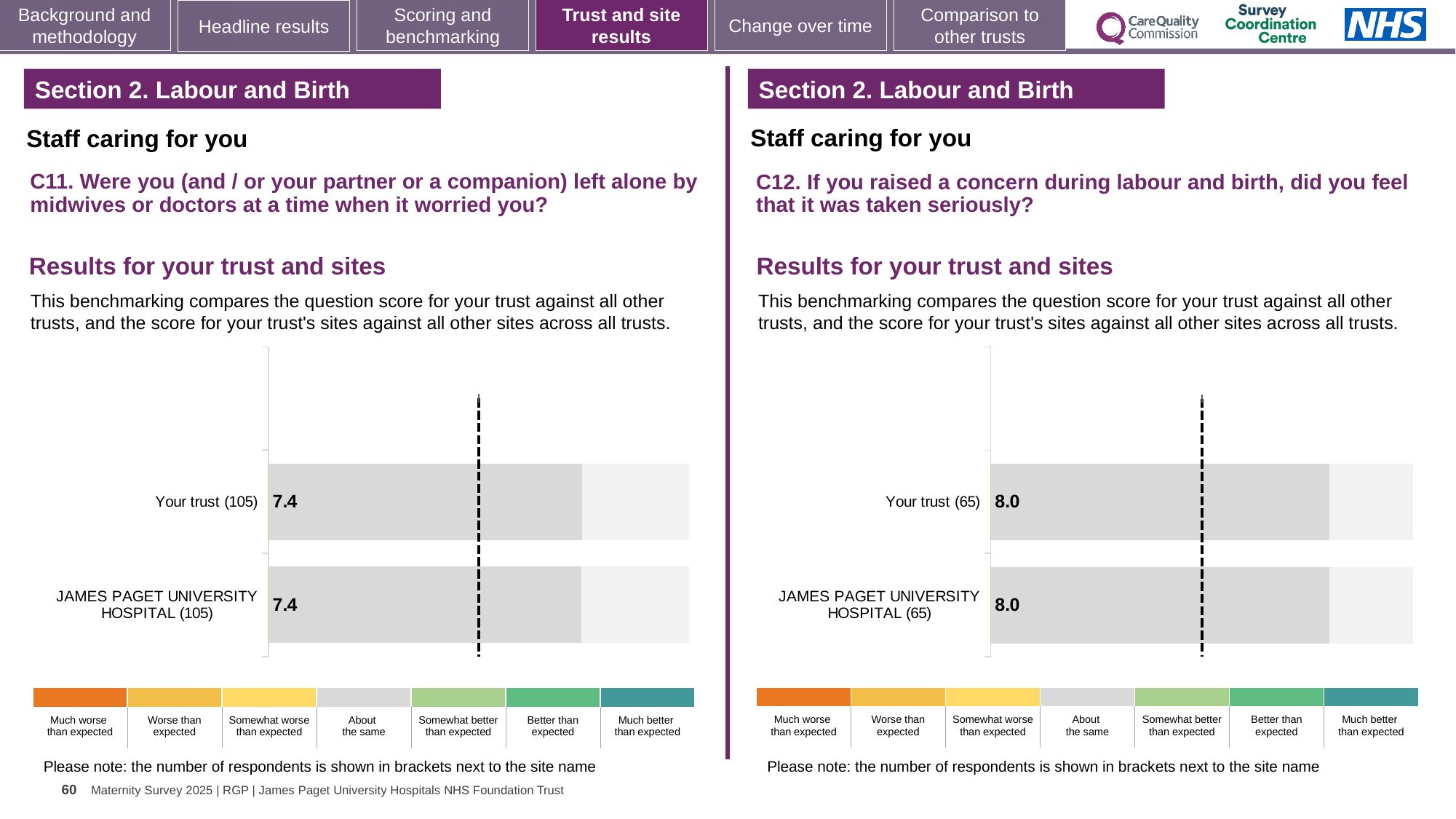
In the right chart (C12), what is the score for JAMES PAGET UNIVERSITY HOSPITAL? 8.0 In the left chart (C11), how many respondents are shown in brackets next to Your trust? 105 In the right chart (C12), what is the score for Your trust? 8.0 In the right chart (C12), how many bars are plotted? 2 In the left chart (C11), what is the score for JAMES PAGET UNIVERSITY HOSPITAL? 7.4 In the left chart (C11), what is the score for Your trust? 7.4 What kind of chart is used on the left side of the slide for C11? Bar chart In the right chart (C12), what is the difference between the score for Your trust and the score for JAMES PAGET UNIVERSITY HOSPITAL? 0.0 In the left chart (C11), what is the difference between the score for Your trust and the score for JAMES PAGET UNIVERSITY HOSPITAL? 0.0 In the left chart (C11), how many bars are plotted? 2 In the right chart (C12), how many respondents are shown in brackets next to JAMES PAGET UNIVERSITY HOSPITAL? 65